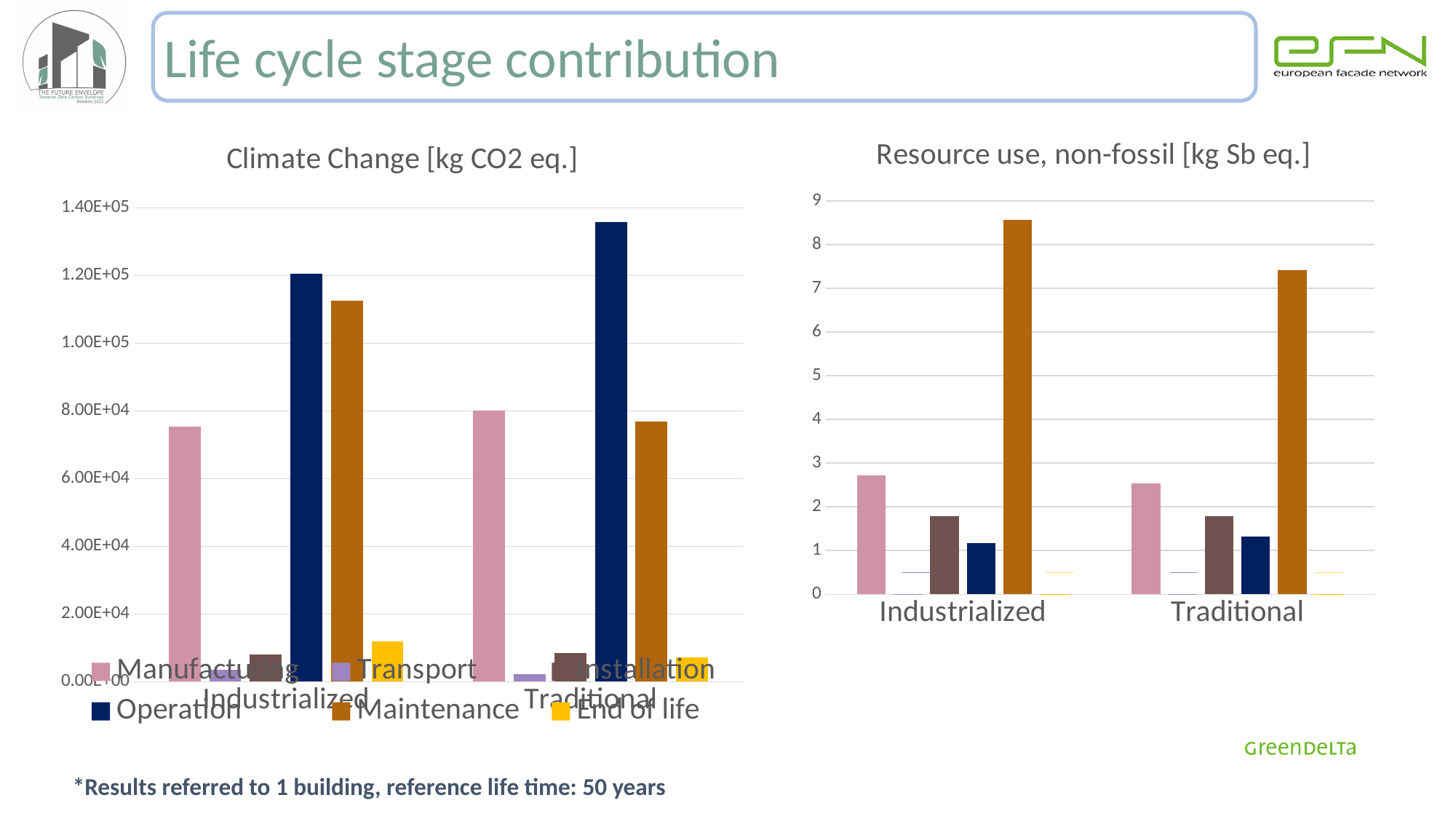
How many categories are shown on the x axis of the "Resource use, non-fossil [kg Sb eq.]" chart? 2 In the "Climate Change [kg CO2 eq.]" chart, which life cycle stage has the highest value for Traditional? Operation In the "Resource use, non-fossil [kg Sb eq.]" chart, is the Maintenance value for Traditional greater or less than 7? greater In the "Resource use, non-fossil [kg Sb eq.]" chart, which life cycle stage has the highest value for Industrialized? Maintenance What kind of chart is the "Climate Change [kg CO2 eq.]" chart? bar chart In the "Resource use, non-fossil [kg Sb eq.]" chart, is the Maintenance value for Industrialized greater or less than 8? greater What is the title of the chart on the right side of the slide? Resource use, non-fossil [kg Sb eq.] How many series does the legend of the "Climate Change [kg CO2 eq.]" chart list? 6 In the "Climate Change [kg CO2 eq.]" chart, is the Maintenance value larger for Industrialized or for Traditional? Industrialized In the "Climate Change [kg CO2 eq.]" chart, is the Manufacturing value for Industrialized greater or less than 8.00E+04? less In the "Climate Change [kg CO2 eq.]" chart, is the Operation value larger for Industrialized or for Traditional? Traditional